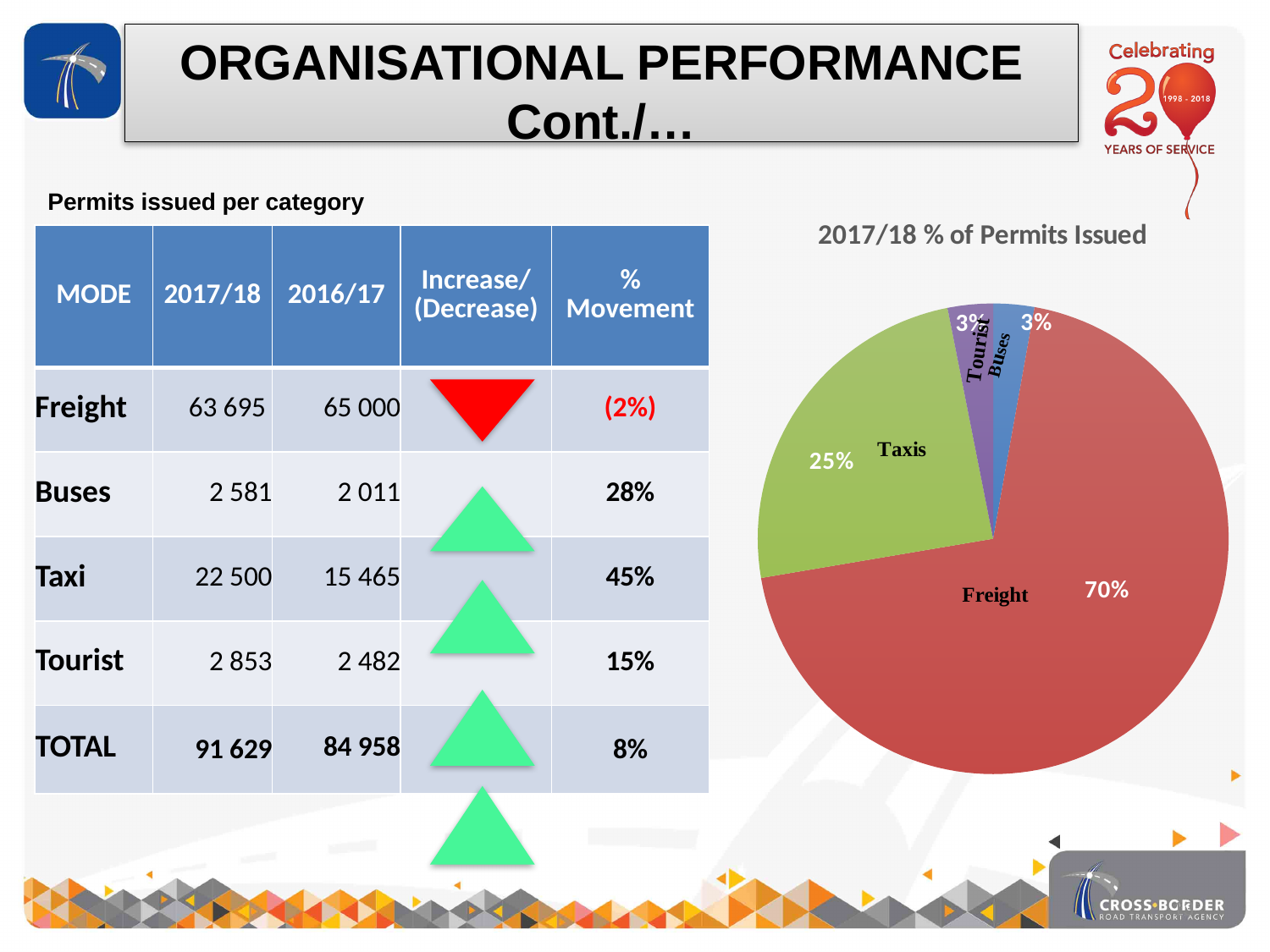
What colour is the Freight slice of the pie? red What kind of chart is shown on the slide? pie chart What share of the pie does Tourist represent? 3% What is the title of the chart? 2017/18 % of Permits Issued What share of the pie does Buses represent? 3% What is the difference in percentage points between the Freight slice and the Taxis slice? 45 What share of the pie does Freight represent? 70% How many slices does the pie chart have? 4 Which is larger, the Taxis slice or the Buses slice? Taxis Which is larger, the Taxis slice or the Freight slice? Freight Which category has the largest slice of the pie? Freight